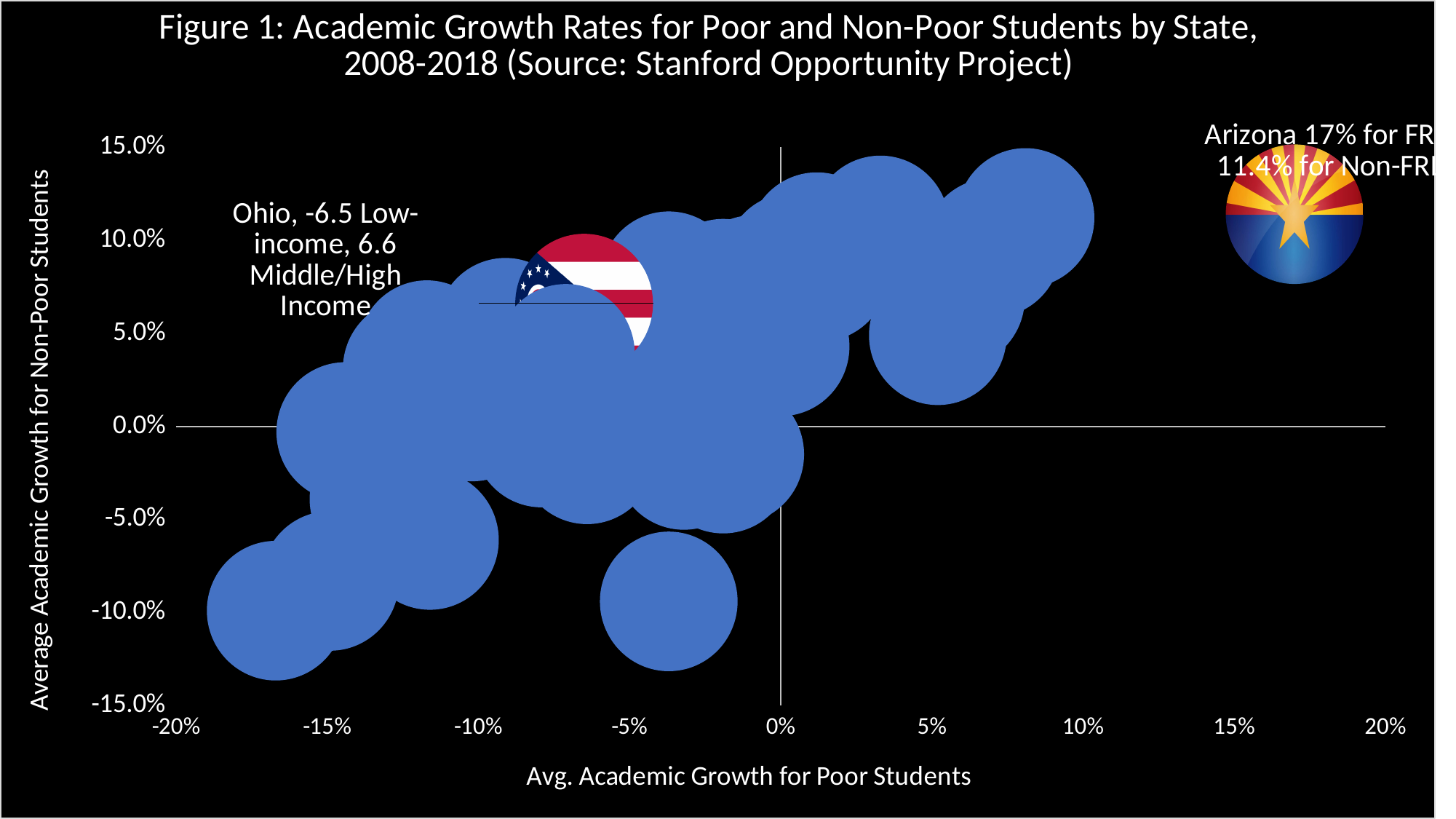
What is the academic growth value for low-income students in Ohio? -6.5 What is Arizona's academic growth rate for non-FRL students? 11.4% What is the source of the data cited in the chart title? Stanford Opportunity Project Which state's bubble is farthest to the right on the x axis (highest growth for poor students)? Arizona What is the difference between Ohio's middle/high income growth (6.6) and its low-income growth (-6.5)? 13.1 What is Arizona's academic growth rate for FRL students? 17% Do the bubbles generally rise or fall as you move from left to right along the x axis? rise Is Ohio's average academic growth for poor students greater or less than 0%? less What kind of chart is shown on the slide? bubble chart Is Arizona's average academic growth for non-poor students greater or less than 10%? greater Which labeled state has the higher academic growth for poor students, Ohio or Arizona? Arizona What is the academic growth value for middle/high income students in Ohio? 6.6